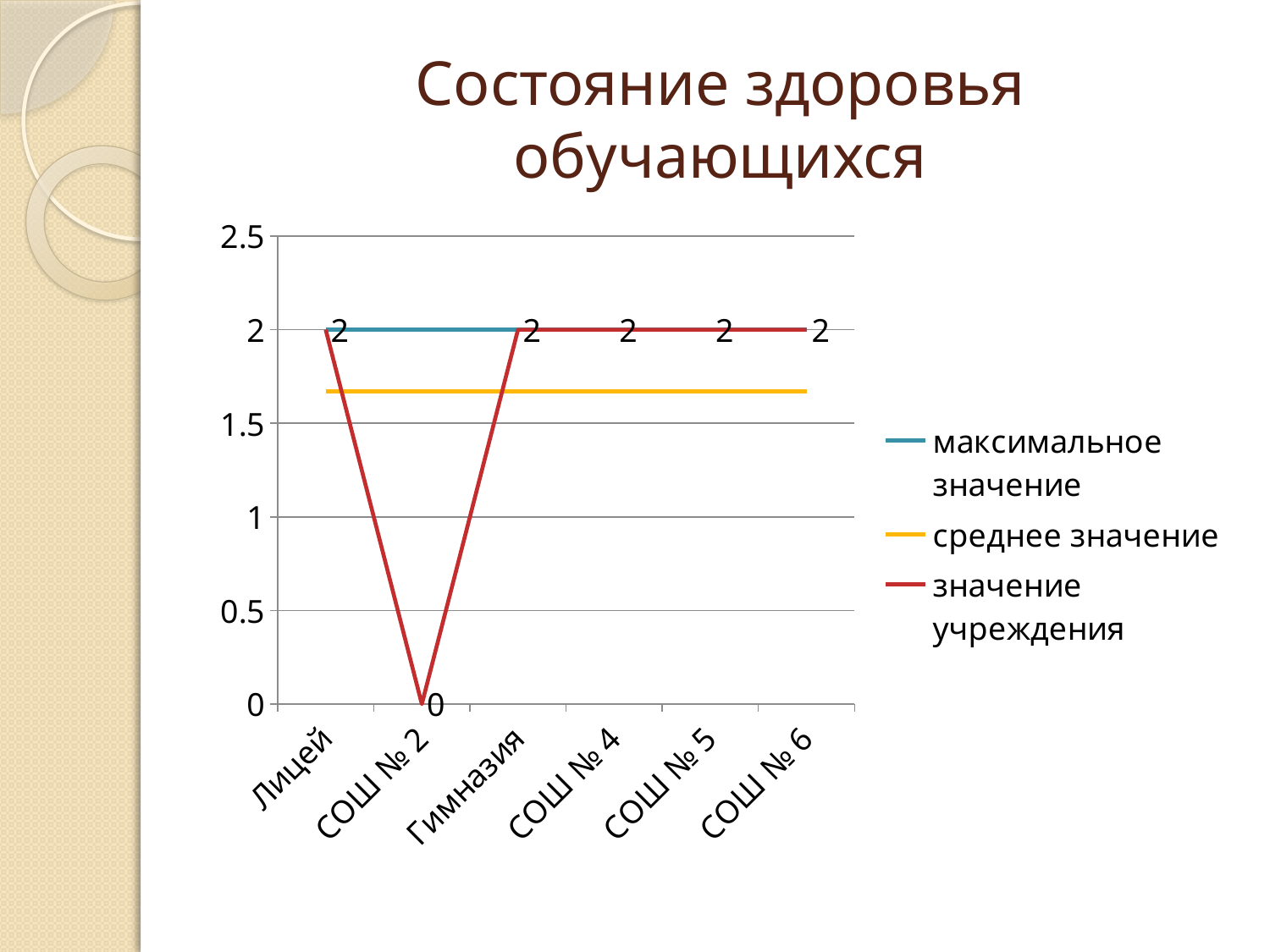
Is the value of среднее значение greater or less than 2? less Is the value of среднее значение greater or less than 1.5? greater Which category has the lowest value for значение учреждения? СОШ № 2 What is the value for значение учреждения at Лицей? 2 What is the difference between the значение учреждения values for Лицей and СОШ № 2? 2 What kind of chart is shown on the slide? line chart Which is larger, the значение учреждения value for СОШ № 4 or for СОШ № 2? СОШ № 4 What is the title of the chart on the slide? Состояние здоровья обучающихся How many categories are shown on the x axis? 6 What is the value for значение учреждения at СОШ № 2? 0 How many series does the legend list? 3 What is the value for значение учреждения at Гимназия? 2